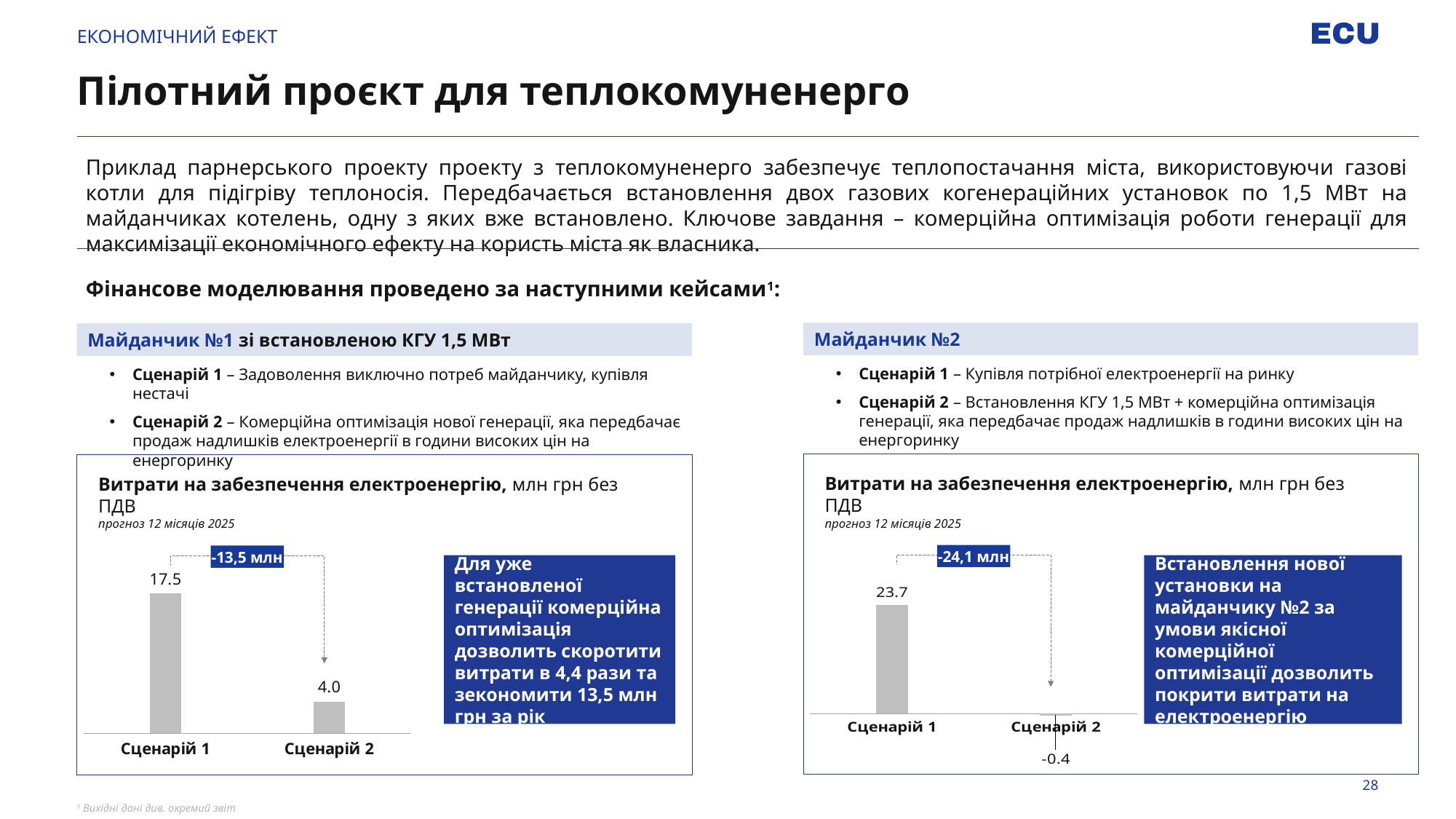
In the right chart (Майданчик №2), what is the difference between Сценарій 1 and Сценарій 2? 24.1 What kind of chart is used on the left (Майданчик №1)? Bar chart In the left chart (Майданчик №1), what is the value for Сценарій 1? 17.5 In the right chart (Майданчик №2), what is the value for Сценарій 2? -0.4 Which is larger: Сценарій 1 in the left chart or Сценарій 1 in the right chart? Сценарій 1 in the right chart (23.7) What unit is stated in the title of the left chart (Майданчик №1)? млн грн без ПДВ In the left chart (Майданчик №1), what is the value for Сценарій 2? 4.0 In the right chart (Майданчик №2), which scenario has the lowest value? Сценарій 2 In the left chart (Майданчик №1), what is the difference between Сценарій 1 and Сценарій 2? 13.5 In the left chart (Майданчик №1), which scenario has the higher cost? Сценарій 1 How many categories are shown in the right chart (Майданчик №2)? 2 In the right chart (Майданчик №2), what is the value for Сценарій 1? 23.7